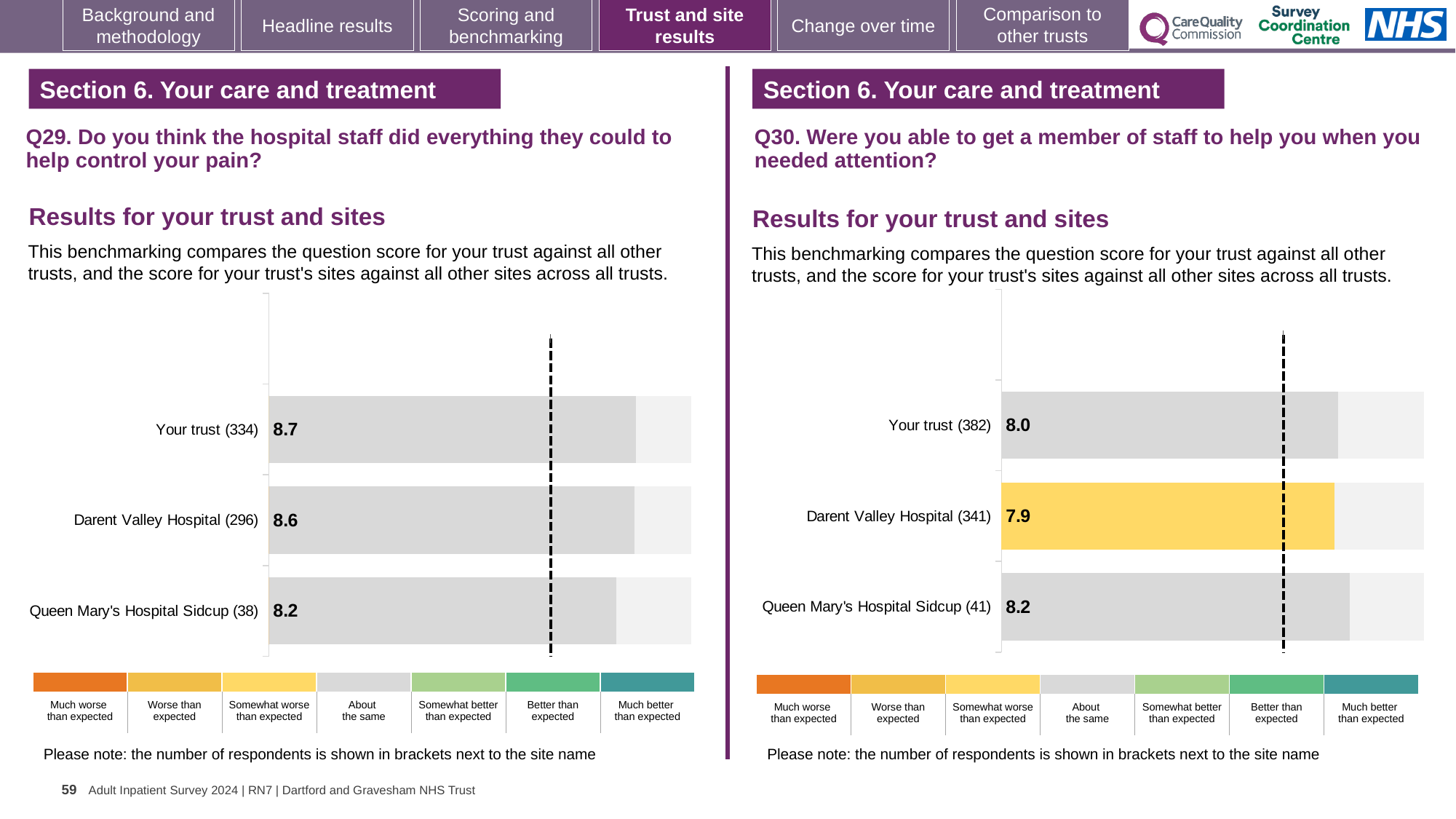
In the Q30 chart on the right, what is the difference between the scores for Queen Mary's Hospital Sidcup and Darent Valley Hospital? 0.3 In the Q29 chart on the left, what is the score for Your trust? 8.7 In the Q29 chart on the left, which site or trust has the lowest score? Queen Mary's Hospital Sidcup In the Q30 chart on the right, which has the larger score, Your trust or Darent Valley Hospital? Your trust In the Q29 chart on the left, how many respondents are shown for Darent Valley Hospital? 296 In the Q29 chart on the left, what is the score for Queen Mary's Hospital Sidcup? 8.2 In the Q30 chart on the right, which site or trust has the highest score? Queen Mary's Hospital Sidcup In the Q30 chart on the right, what is the score for Your trust? 8.0 In the Q30 chart on the right, what is the score for Darent Valley Hospital? 7.9 In the Q30 chart on the right, which benchmark category does the colour of the Darent Valley Hospital bar indicate? Somewhat worse than expected How many bars are plotted in the Q30 chart on the right? 3 In the Q29 chart on the left, what is the difference between the scores for Your trust and Queen Mary's Hospital Sidcup? 0.5